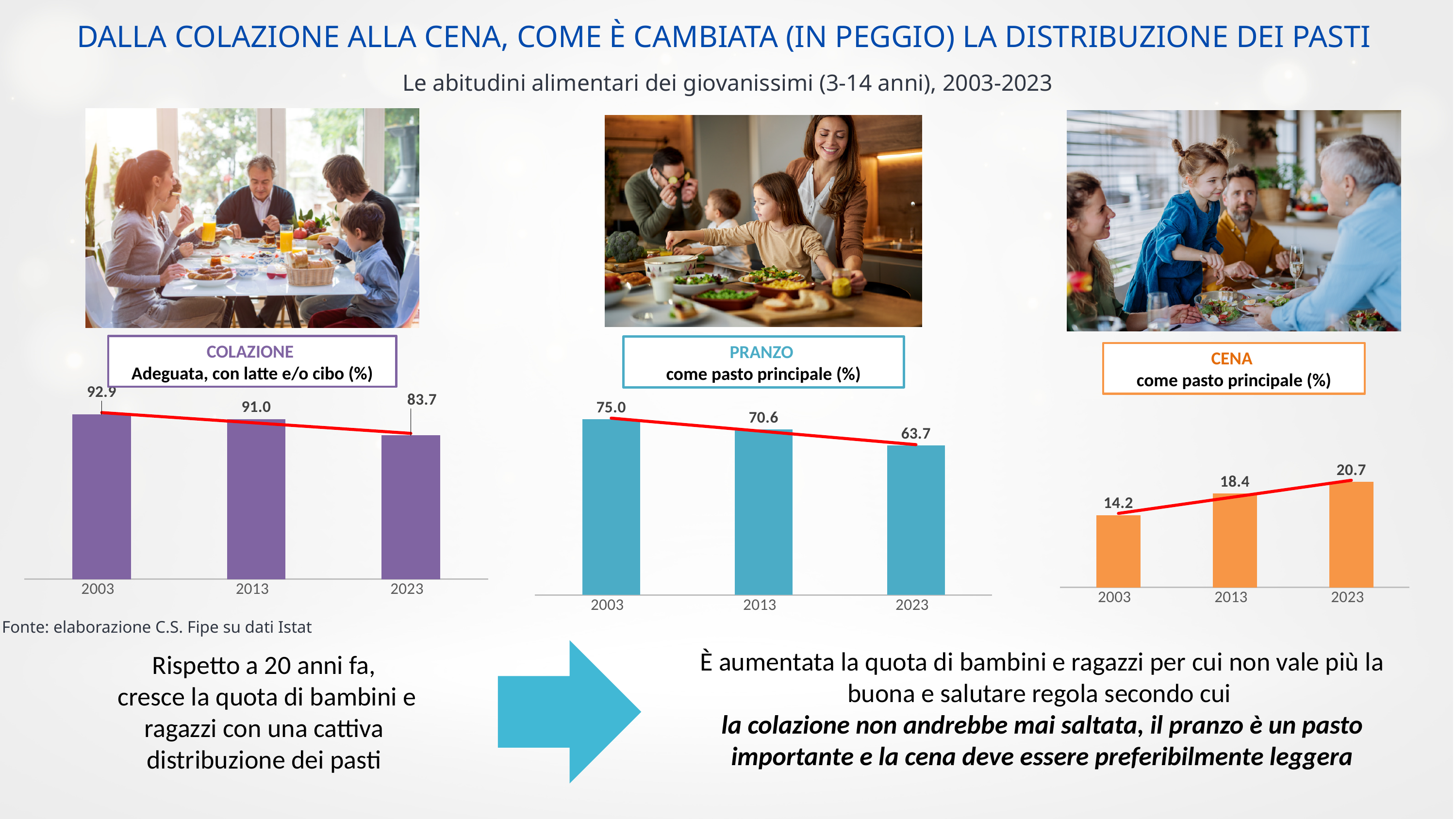
In the PRANZO chart, which year has the lowest value? 2023 In the COLAZIONE chart, do the values rise or fall from 2003 to 2023? fall In the COLAZIONE chart, what is the value for 2003? 92.9 In the COLAZIONE chart, what is the difference between the 2003 and 2023 values? 9.2 In the CENA chart, what is the value for 2003? 14.2 In the CENA chart, is the value for 2013 larger or smaller than the value for 2003? larger How many years are shown in the PRANZO chart? 3 In the PRANZO chart, what is the value for 2013? 70.6 What kind of chart is the CENA chart? bar chart In the CENA chart, which year has the highest value? 2023 In the PRANZO chart, what is the difference between the 2003 and 2023 values? 11.3 In the COLAZIONE chart, what is the value for 2023? 83.7